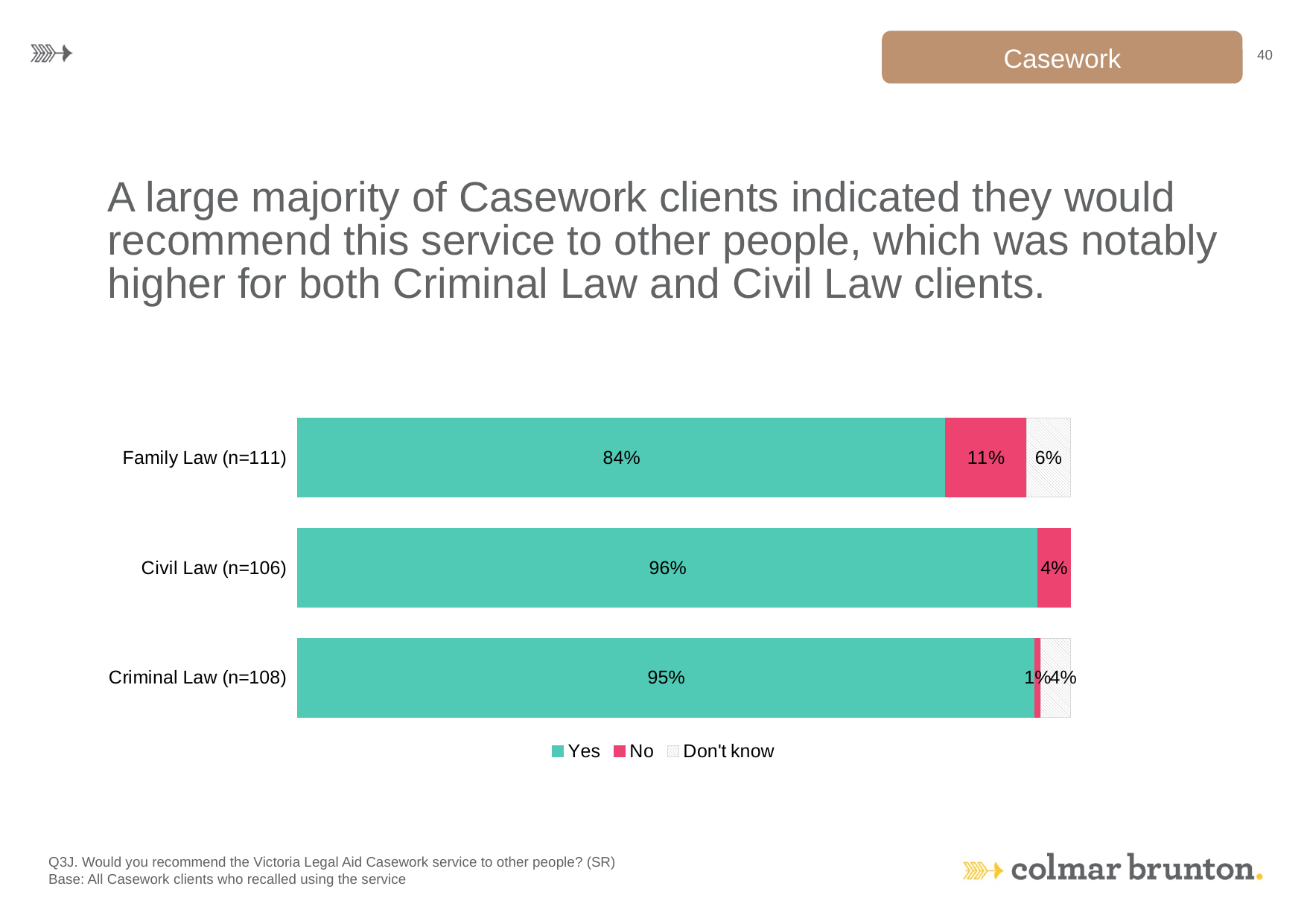
What type of chart is shown on the slide? Stacked bar chart Which group has a larger No percentage, Family Law or Criminal Law? Family Law Which client group has the highest Yes percentage? Civil Law (n=106) What is the difference in percentage points between the Yes share for Civil Law and the Yes share for Family Law? 12 How many client groups are shown in the chart? 3 What percentage of Criminal Law clients answered Don't know? 4% How many series does the legend list? 3 What percentage of Civil Law clients said No? 4% What percentage of Criminal Law clients said No? 1% What are the three response categories listed in the legend? Yes, No, Don't know Which client group has the lowest Yes percentage? Family Law (n=111) What percentage of Family Law clients said Yes, they would recommend the service? 84%